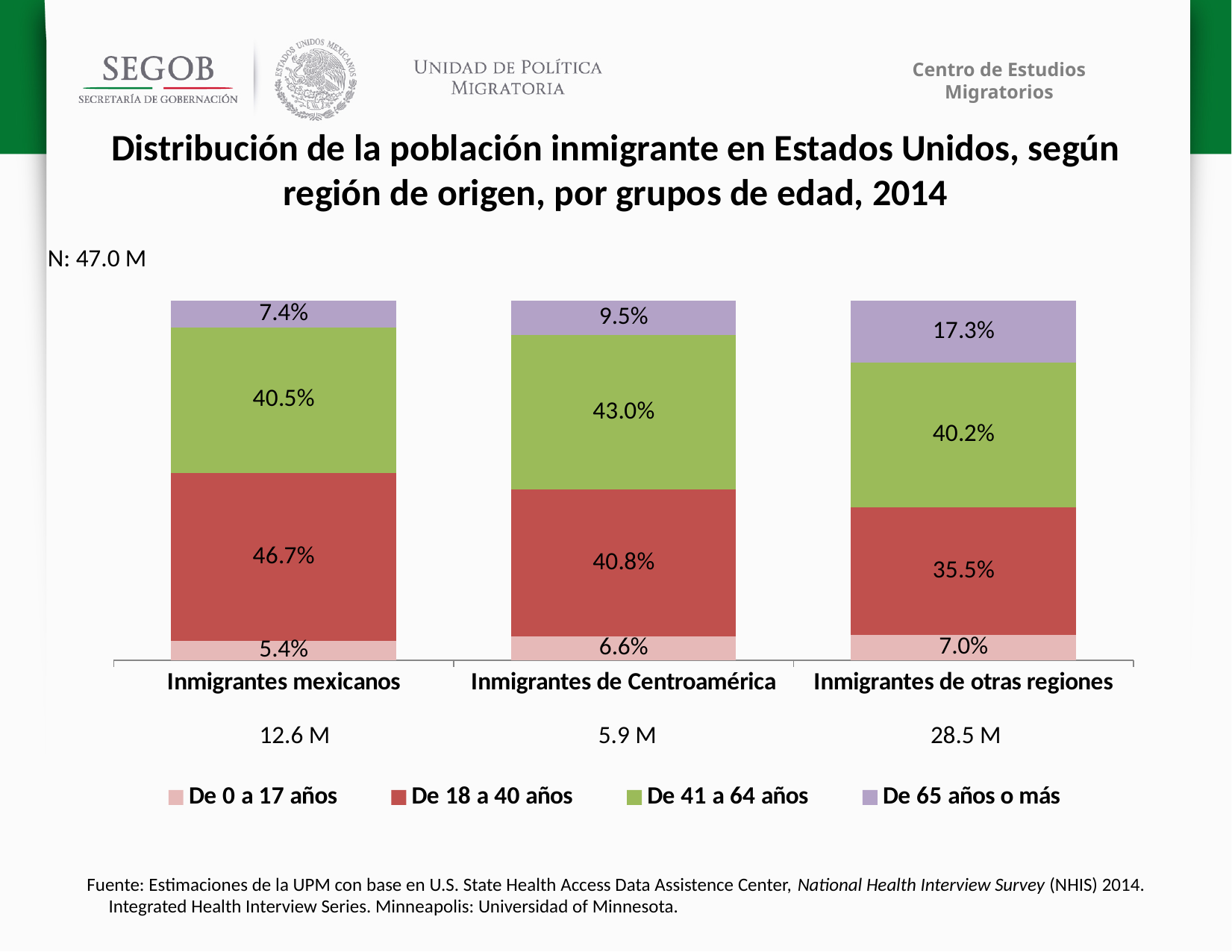
Which is larger: the 'De 41 a 64 años' share for Inmigrantes de Centroamérica or for Inmigrantes mexicanos? Inmigrantes de Centroamérica Which region of origin has the highest share in the 'De 65 años o más' group? Inmigrantes de otras regiones Which region of origin has the lowest share in the 'De 0 a 17 años' group? Inmigrantes mexicanos What population size is shown below the Inmigrantes de otras regiones bar? 28.5 M How many age groups does the legend list? 4 What is the difference between the 'De 18 a 40 años' share for Inmigrantes mexicanos and for Inmigrantes de otras regiones? 11.2 percentage points What is the total population (N) indicated for the chart? 47.0 M What kind of chart is shown on the slide? Stacked bar chart How many regions of origin are shown on the x axis? 3 What percentage of Inmigrantes mexicanos are in the 'De 18 a 40 años' group? 46.7% What percentage of Inmigrantes de otras regiones are 'De 65 años o más'? 17.3% What is the value for 'De 0 a 17 años' among Inmigrantes de Centroamérica? 6.6%